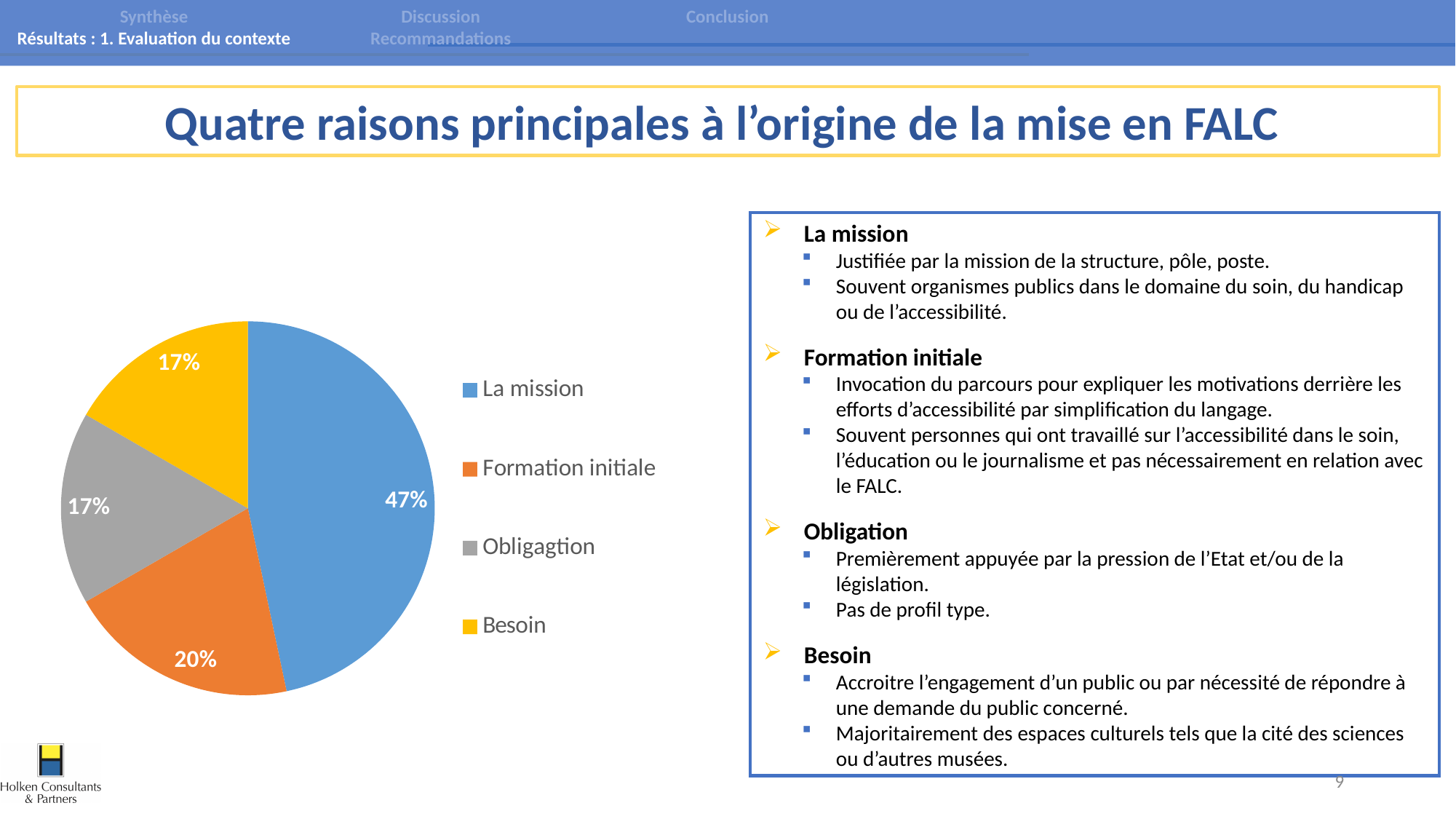
Which legend entry is shown in grey? Obligagtion How many entries does the legend list? 4 What is the difference in percentage points between La mission and Formation initiale? 27 Which category has the largest slice of the pie? La mission What share of the pie does La mission represent? 47% What kind of chart is shown on the slide? Pie chart Which is larger, the slice for Formation initiale or the slice for Besoin? Formation initiale How many slices does the pie chart have? 4 What colour is the slice for Besoin? Yellow Is the share for La mission greater or less than 50%? less What percentage is shown for Formation initiale? 20% What percentage is shown for Besoin? 17%